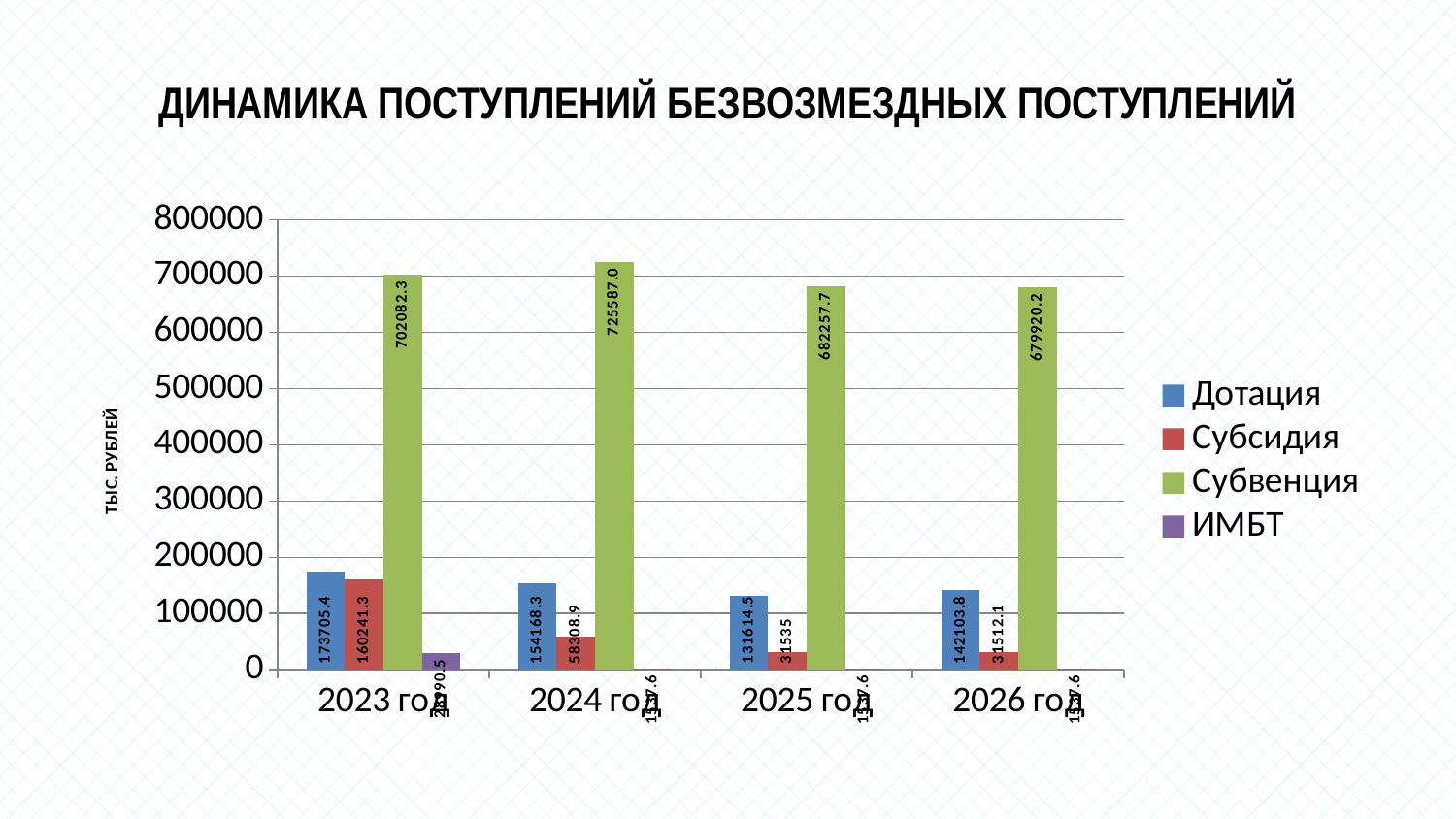
What kind of chart is shown on the slide? bar chart In which year is Субвенция highest? 2024 год How many series does the legend list? 4 What is the value for Субсидия in 2025 год? 31535 Which is larger: Субсидия in 2023 год or Субсидия in 2024 год? Субсидия in 2023 год What is the difference between Дотация in 2023 год and Дотация in 2024 год? 19537.1 What is the value for Субвенция in 2026 год? 679920.2 In which year is Дотация lowest? 2025 год What is the value for Субвенция in 2024 год? 725587.0 Does the value for Субсидия rise or fall from 2023 год to 2025 год? fall Is the value for Субвенция in 2025 год greater or less than 700000? less What is the value for Дотация in 2023 год? 173705.4